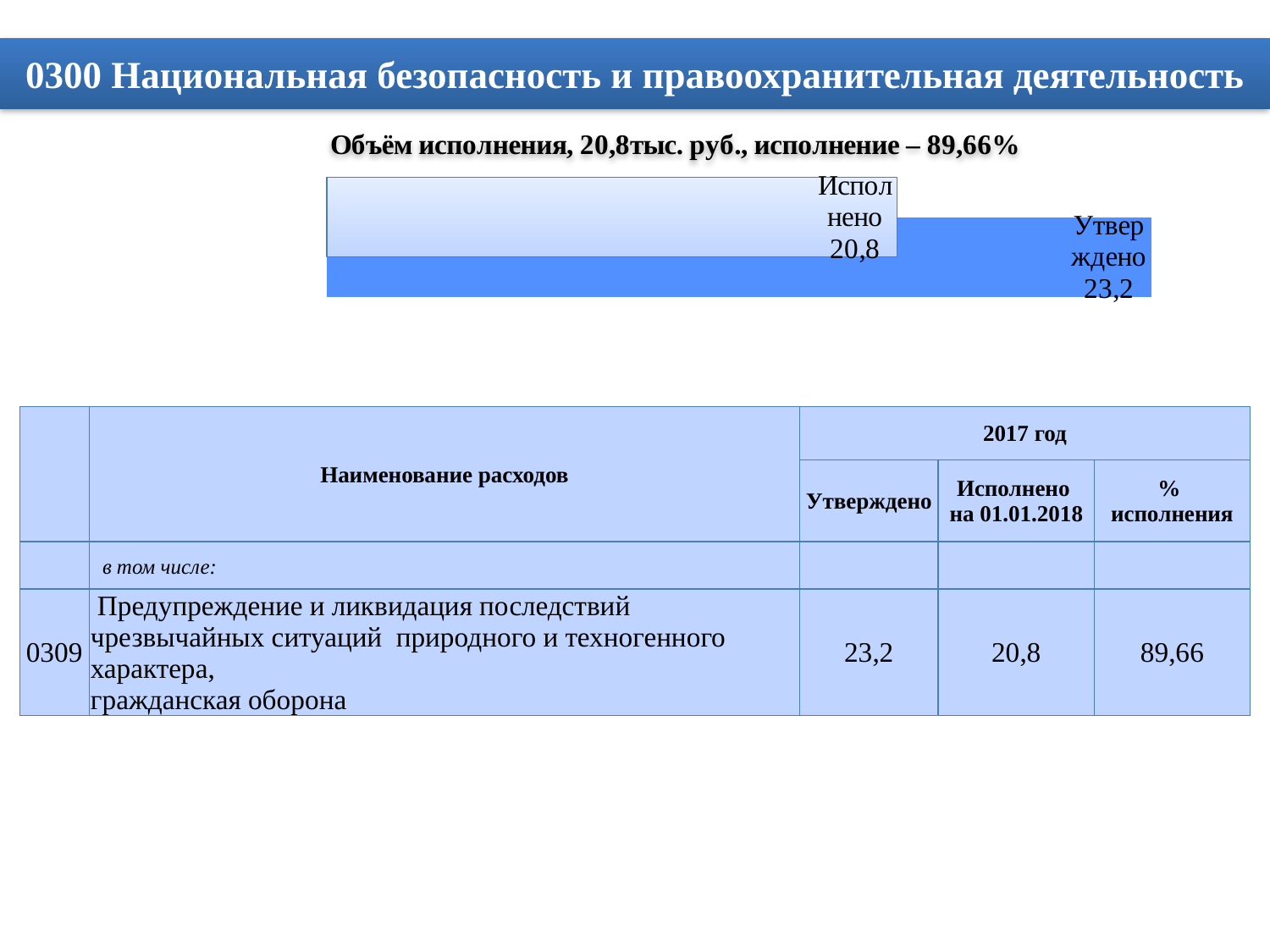
Which bar has the lowest value? Исполнено What is the difference between the Утверждено and Исполнено values? 2,4 What is the title shown above the chart? Объём исполнения, 20,8тыс. руб., исполнение – 89,66% What are the labels of the two bars in the chart? Исполнено and Утверждено Which is larger, Утверждено or Исполнено? Утверждено What type of chart is shown on the slide? bar chart What is the value of the bar labelled Утверждено? 23,2 How many bars does the chart show? 2 Which bar has the highest value? Утверждено What is the value of the bar labelled Исполнено? 20,8